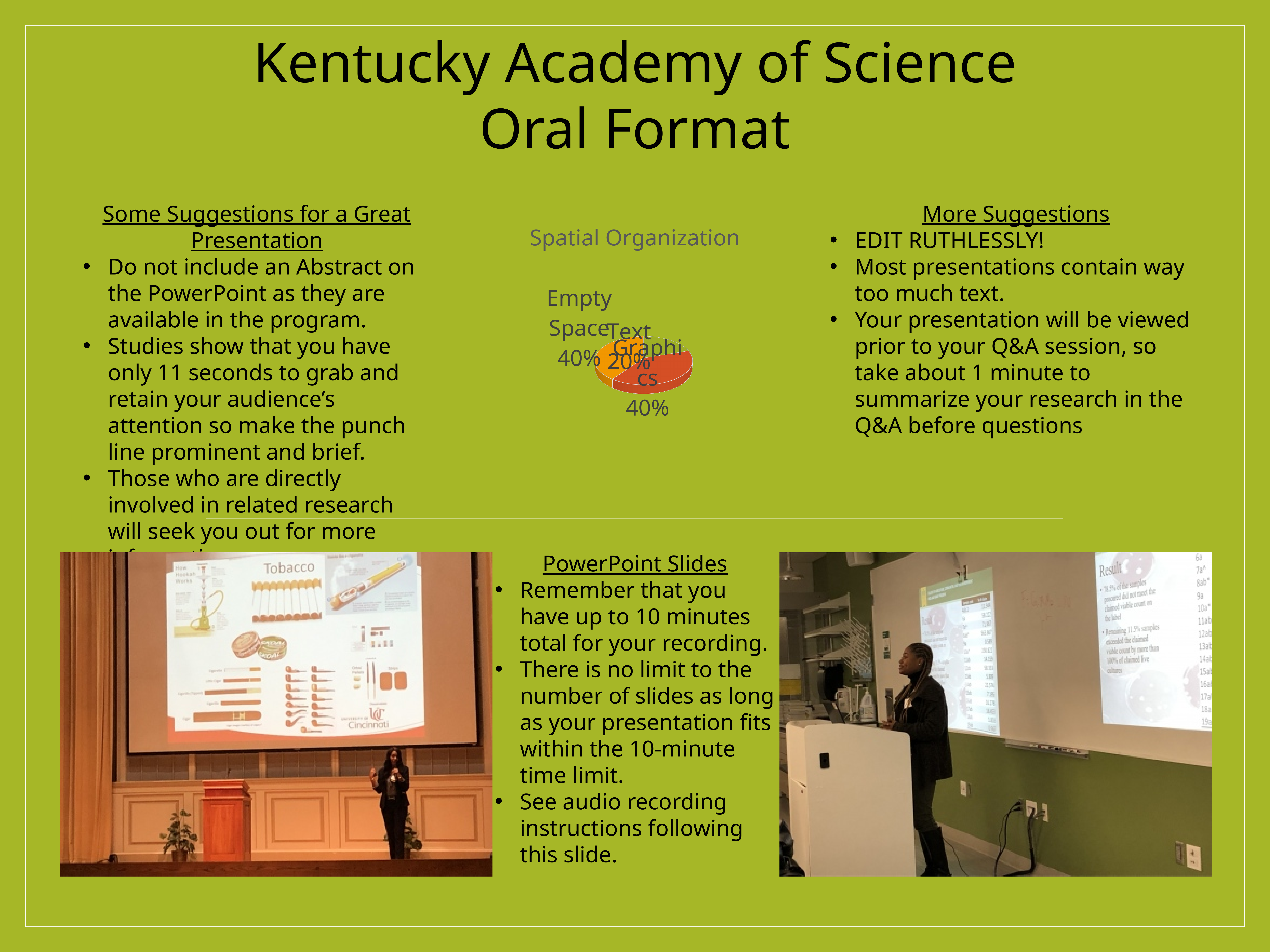
What share of the Spatial Organization pie is Empty Space? 40% Which two categories in the Spatial Organization pie chart have equal shares? Empty Space and Graphics What is the difference between the Graphics share and the Text share in the Spatial Organization pie chart? 20% What share of the Spatial Organization pie is Text? 20% What is the difference between the Empty Space share and the Text share in the Spatial Organization pie chart? 20% In the Spatial Organization pie chart, which is larger: Graphics or Text? Graphics What is the title of the pie chart? Spatial Organization In the Spatial Organization pie chart, which is larger: Empty Space or Text? Empty Space How many slices does the Spatial Organization pie chart have? 3 Which category has the smallest slice in the Spatial Organization pie chart? Text What share of the Spatial Organization pie is Graphics? 40% What kind of chart is shown under the heading Spatial Organization? pie chart